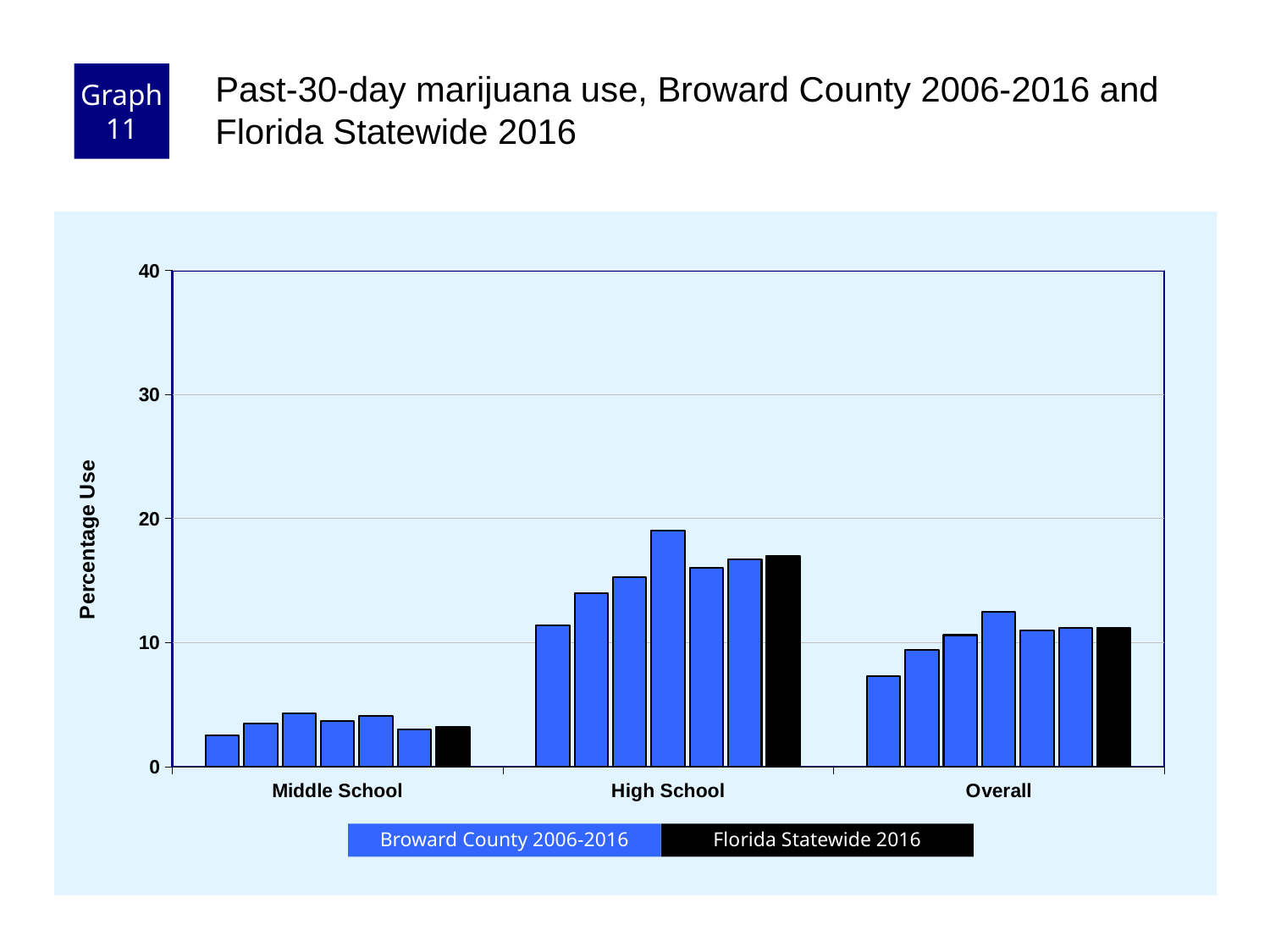
Is the tallest Broward County bar for High School greater or less than 20? less Is the Florida Statewide 2016 value for Middle School greater or less than 10? less Which is larger: the Florida Statewide 2016 value for High School or for Overall? High School What kind of chart is shown on the slide? Bar chart Which category has the shortest bars? Middle School How many categories are shown on the x axis? 3 Is the Florida Statewide 2016 value for Overall greater or less than 10? greater Which category has the tallest bars? High School How many series does the legend list? 2 What colour are the Florida Statewide 2016 bars? Black What is the title of the y axis? Percentage Use